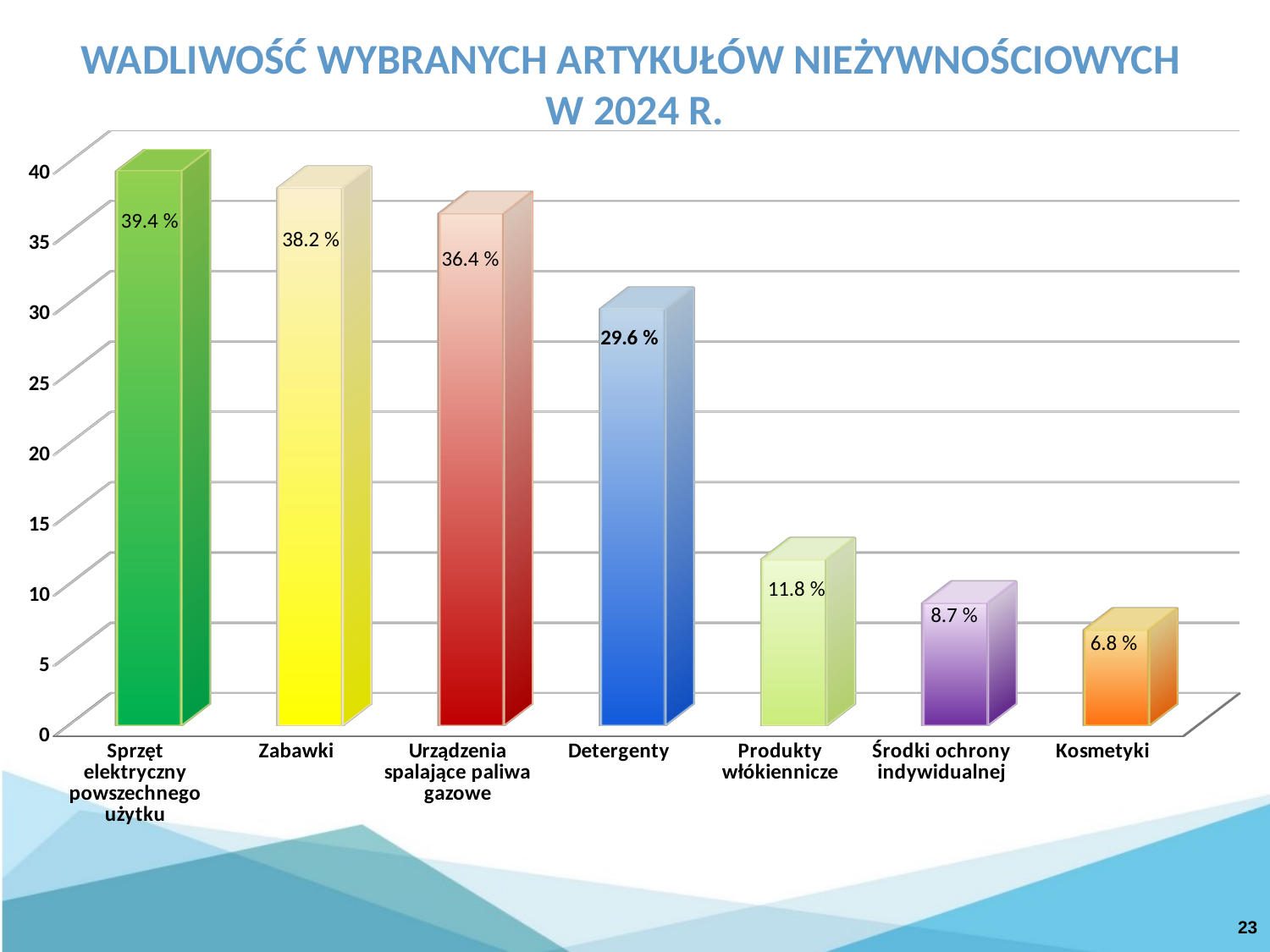
What is the value for Środki ochrony indywidualnej? 8.7 % Which category has the highest value? Sprzęt elektryczny powszechnego użytku Which is larger, the value for Urządzenia spalające paliwa gazowe or the value for Detergenty? Urządzenia spalające paliwa gazowe Which category has the lowest value? Kosmetyki What is the title of the chart? WADLIWOŚĆ WYBRANYCH ARTYKUŁÓW NIEŻYWNOŚCIOWYCH W 2024 R. What is the value for Zabawki? 38.2 % What kind of chart is shown on the slide? bar chart What is the difference between the values for Sprzęt elektryczny powszechnego użytku and Zabawki? 1.2 % What is the difference between the values for Detergenty and Produkty włókiennicze? 17.8 % What is the value for Detergenty? 29.6 % What is the value for Kosmetyki? 6.8 % How many categories are shown on the chart? 7